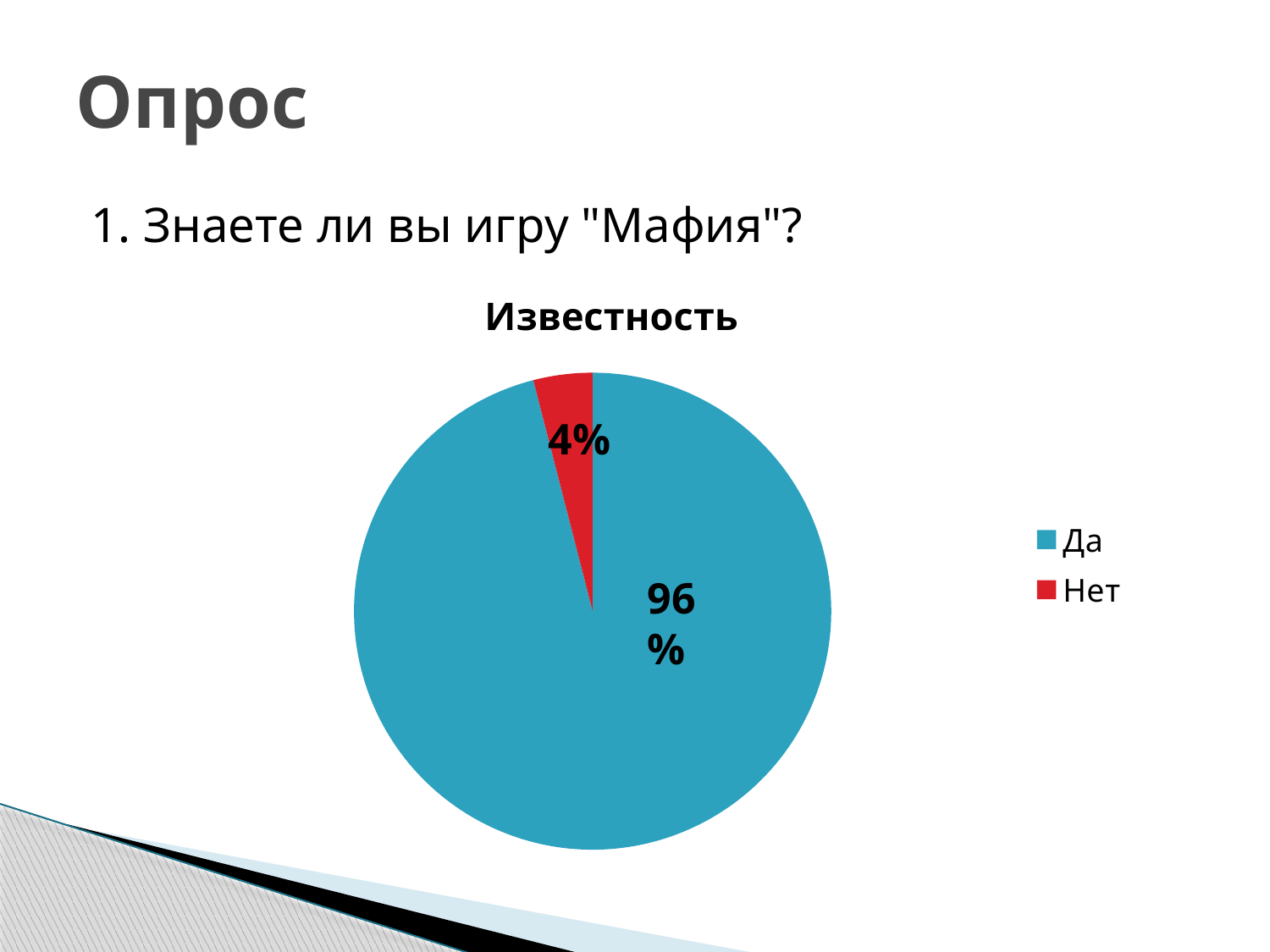
What colour is the slice for "Нет"? red Is the share for "Да" greater or less than 50%? greater What share of the pie does "Нет" take? 4% What is the title of the chart? Известность What type of chart is shown on the slide? pie chart What is the difference in percentage points between "Да" and "Нет"? 92 What share of the pie does "Да" take? 96% Which category has the smallest slice? Нет Which category has the largest slice? Да How many categories does the legend list? 2 Which is larger, the slice for "Да" or the slice for "Нет"? Да